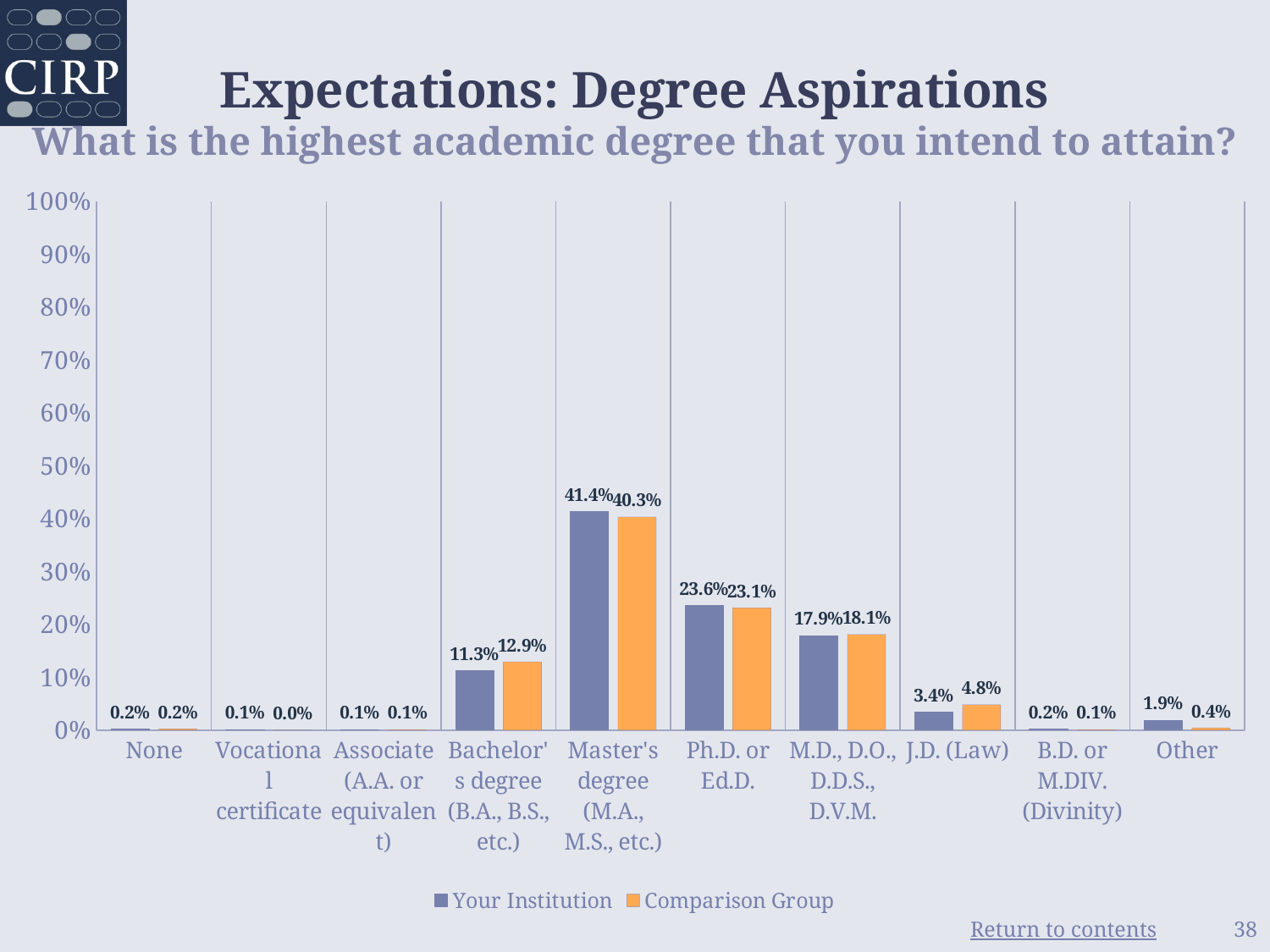
Which category has the highest value for Your Institution? Master's degree (M.A., M.S., etc.) What kind of chart is shown on the slide? Bar chart What is the value for Your Institution for Master's degree (M.A., M.S., etc.)? 41.4% What is the value for Comparison Group for Other? 0.4% Which is larger for M.D., D.O., D.D.S., D.V.M.: Your Institution or Comparison Group? Comparison Group How many series does the legend list? 2 Which category has the lowest value for Comparison Group? Vocational certificate What is the value for Your Institution for J.D. (Law)? 3.4% What is the difference between Your Institution and Comparison Group for Ph.D. or Ed.D.? 0.5% What is the value for Comparison Group for Bachelor's degree (B.A., B.S., etc.)? 12.9% What colour are the Comparison Group bars? Orange How many categories are shown on the x axis? 10